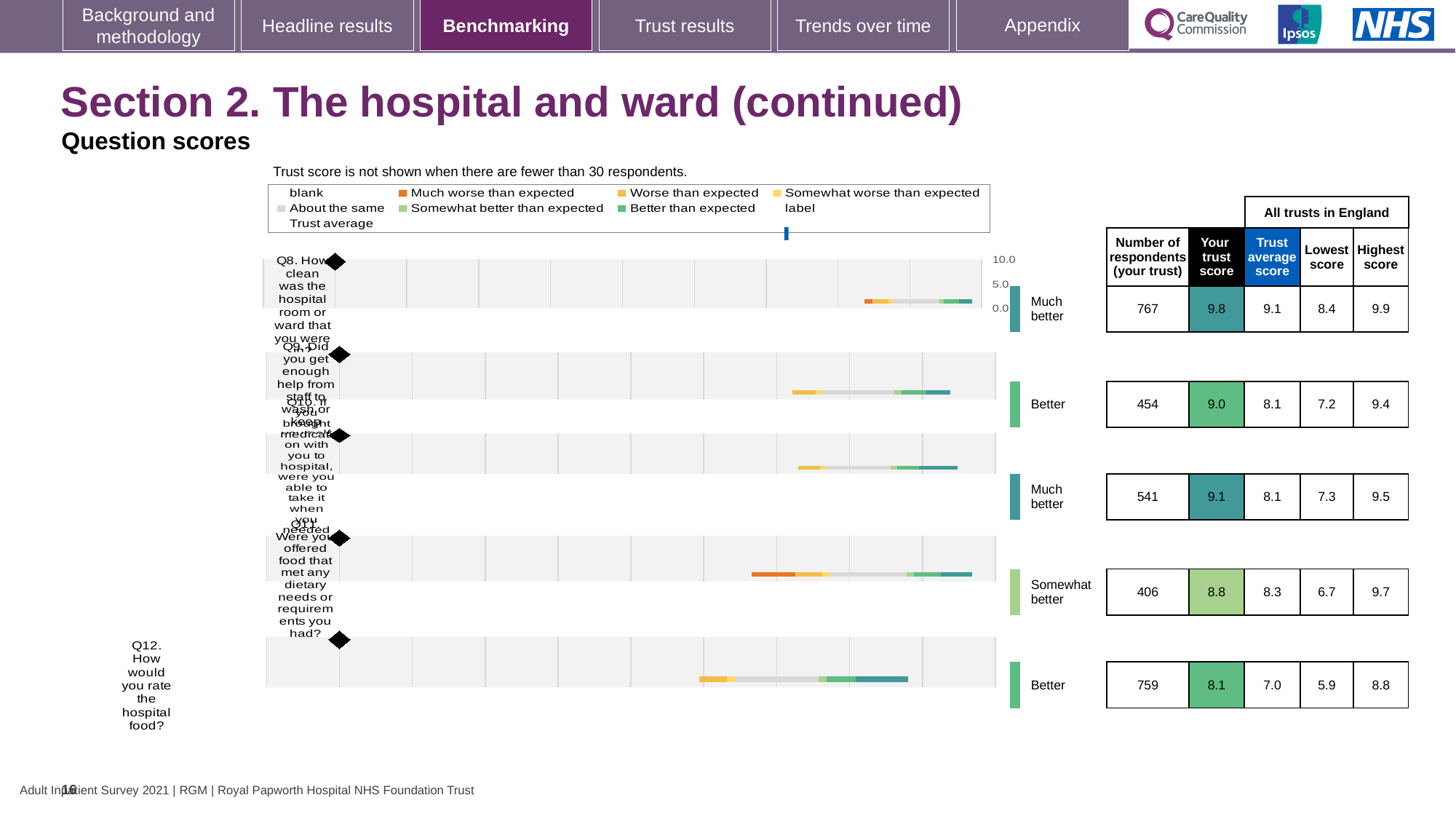
How many questions (bars) are plotted in the question scores chart? 5 What is the 'Lowest score' across all trusts in England for Q12? 5.9 For Q8, what is the difference between the highest score and the lowest score across all trusts in England? 1.5 Which question has the highest 'Your trust score'? Q8 Which has the higher 'Your trust score', Q9 or Q10? Q10 For Q12, what is the difference between 'Your trust score' and the 'Trust average score'? 1.1 What kind of chart is used to show the question scores on this slide? bar chart What is the 'Your trust score' for Q8 (how clean was the hospital room or ward)? 9.8 What benchmark category is shown for Q11? Somewhat better Which question has the lowest 'Your trust score'? Q12 How many respondents answered Q12 (how would you rate the hospital food)? 759 What is the maximum value shown on the chart's score axis? 10.0